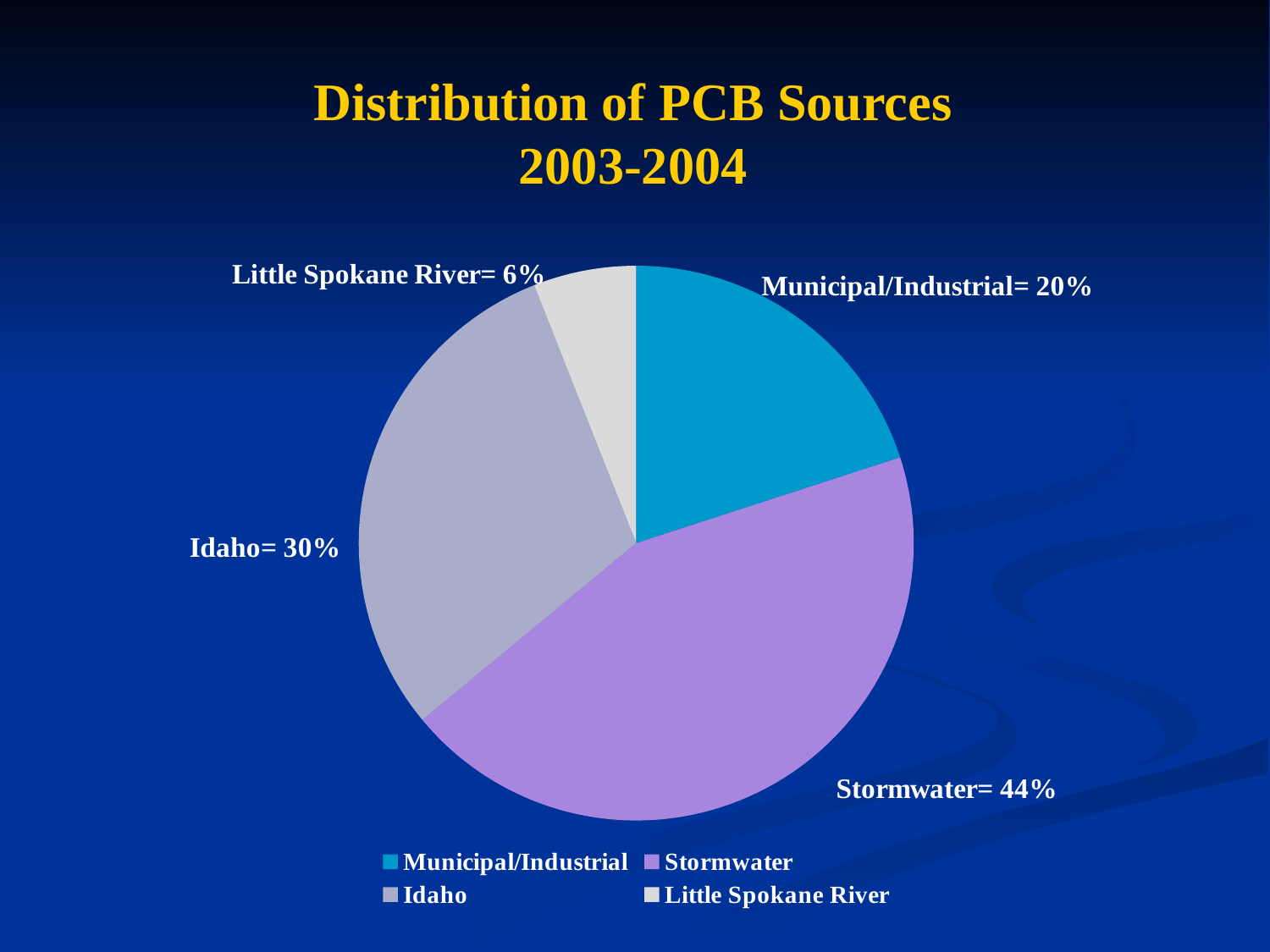
How many percentage points larger is the Municipal/Industrial share than the Little Spokane River share? 14 What share of PCB sources does the Little Spokane River account for? 6% What share of PCB sources does Idaho account for? 30% How many percentage points larger is the Stormwater share than the Idaho share? 14 Which PCB source has the smallest share of the pie? Little Spokane River What is the title of the chart? Distribution of PCB Sources 2003-2004 Which PCB source has the largest share of the pie? Stormwater What kind of chart is shown on the slide? Pie chart What share of PCB sources does Municipal/Industrial account for? 20% How many PCB source categories are shown in the pie chart? 4 Which is larger, the Idaho share or the Municipal/Industrial share? Idaho What share of PCB sources does Stormwater account for? 44%